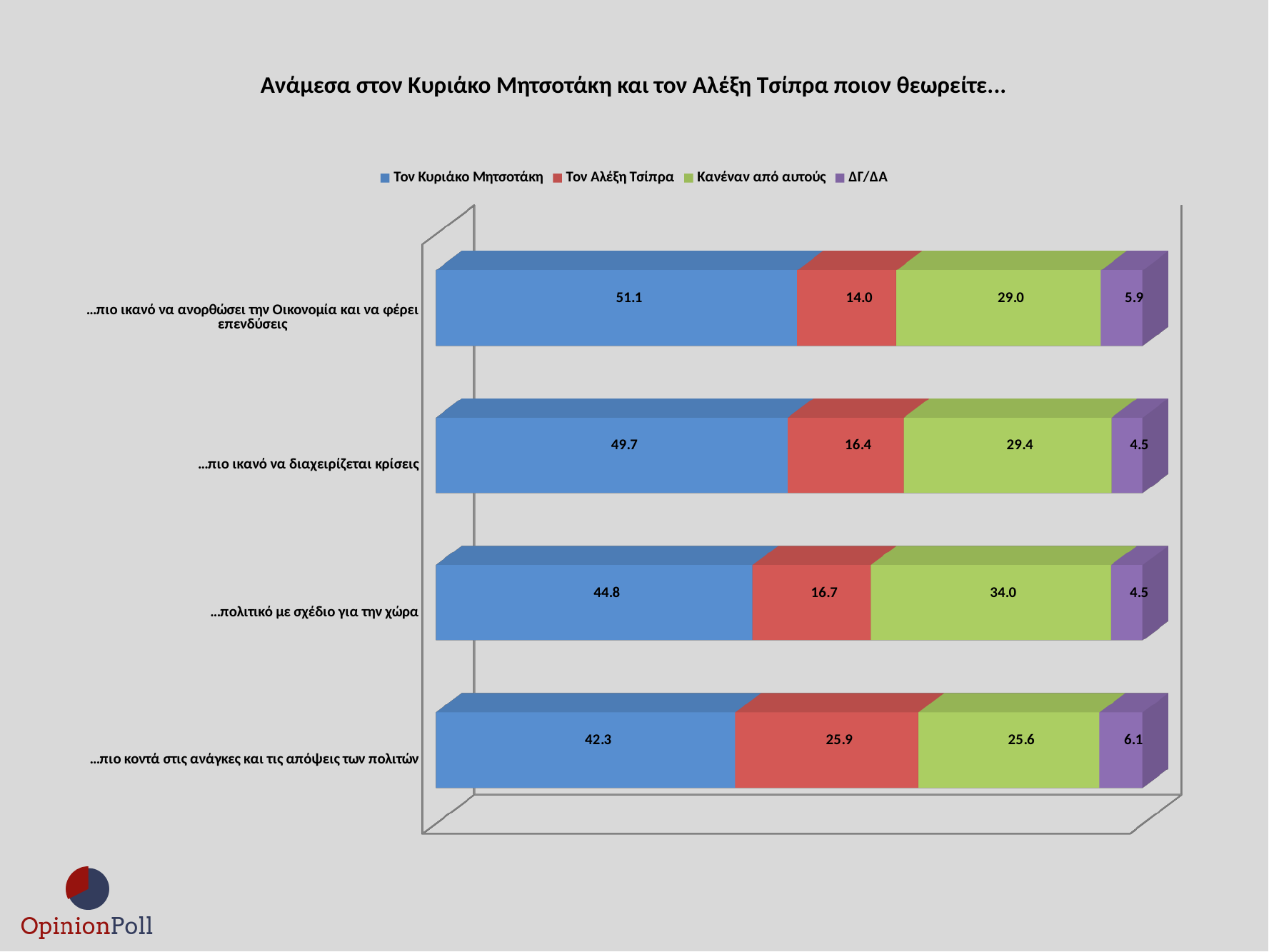
What is the value for Τον Κυριάκο Μητσοτάκη in the category "...πιο ικανό να ανορθώσει την Οικονομία και να φέρει επενδύσεις"? 51.1 In which category does Τον Αλέξη Τσίπρα have the lowest value? ...πιο ικανό να ανορθώσει την Οικονομία και να φέρει επενδύσεις What is the value for ΔΓ/ΔΑ in the category "...πιο ικανό να διαχειρίζεται κρίσεις"? 4.5 In the category "...πιο κοντά στις ανάγκες και τις απόψεις των πολιτών", which is larger: the value for Τον Αλέξη Τσίπρα or for Κανέναν από αυτούς? Τον Αλέξη Τσίπρα How many categories are shown on the chart? 4 What is the difference between the values for Τον Κυριάκο Μητσοτάκη and Τον Αλέξη Τσίπρα in the category "...πιο ικανό να διαχειρίζεται κρίσεις"? 33.3 What is the total of the stacked bar for "...πολιτικό με σχέδιο για την χώρα"? 100.0 What is the value for Τον Αλέξη Τσίπρα in the category "...πιο κοντά στις ανάγκες και τις απόψεις των πολιτών"? 25.9 In which category does Τον Κυριάκο Μητσοτάκη have the highest value? ...πιο ικανό να ανορθώσει την Οικονομία και να φέρει επενδύσεις How many series does the legend list? 4 What is the value for Κανέναν από αυτούς in the category "...πολιτικό με σχέδιο για την χώρα"? 34.0 What kind of chart is shown on the slide? Stacked bar chart